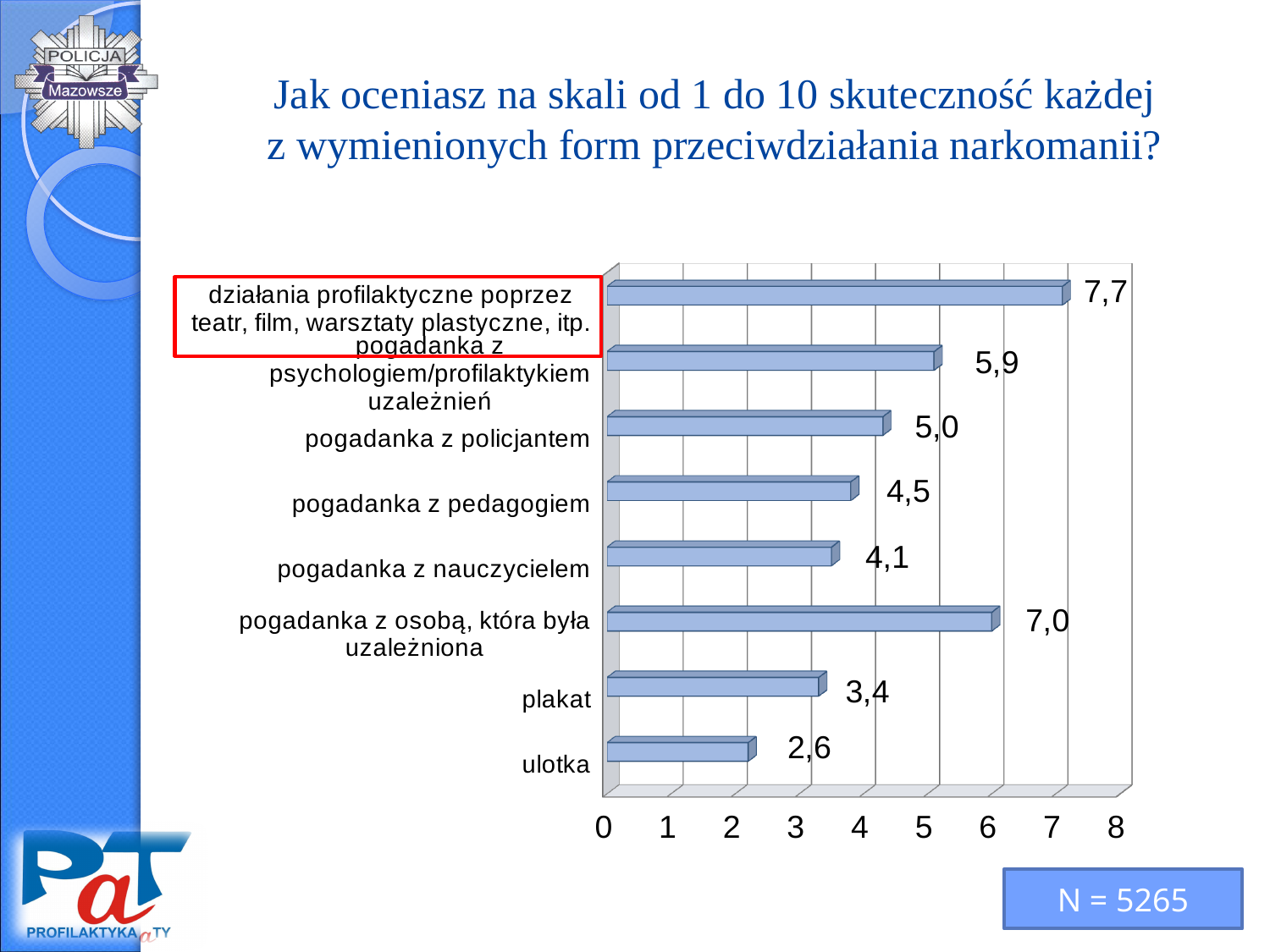
What is the value for "pogadanka z osobą, która była uzależniona"? 7,0 What is the difference between the values for "działania profilaktyczne poprzez teatr, film, warsztaty plastyczne, itp." and "pogadanka z osobą, która była uzależniona"? 0,7 How many categories are shown in the chart? 8 What is the value for "pogadanka z policjantem"? 5,0 Which category has the highest value? działania profilaktyczne poprzez teatr, film, warsztaty plastyczne, itp. What kind of chart is shown on the slide? bar chart Which category has the lowest value? ulotka Which has a larger value, "pogadanka z pedagogiem" or "pogadanka z nauczycielem"? pogadanka z pedagogiem What sample size (N) is shown on the slide? N = 5265 What is the value for "ulotka"? 2,6 What is the value for "plakat"? 3,4 What is the difference between the values for "plakat" and "ulotka"? 0,8